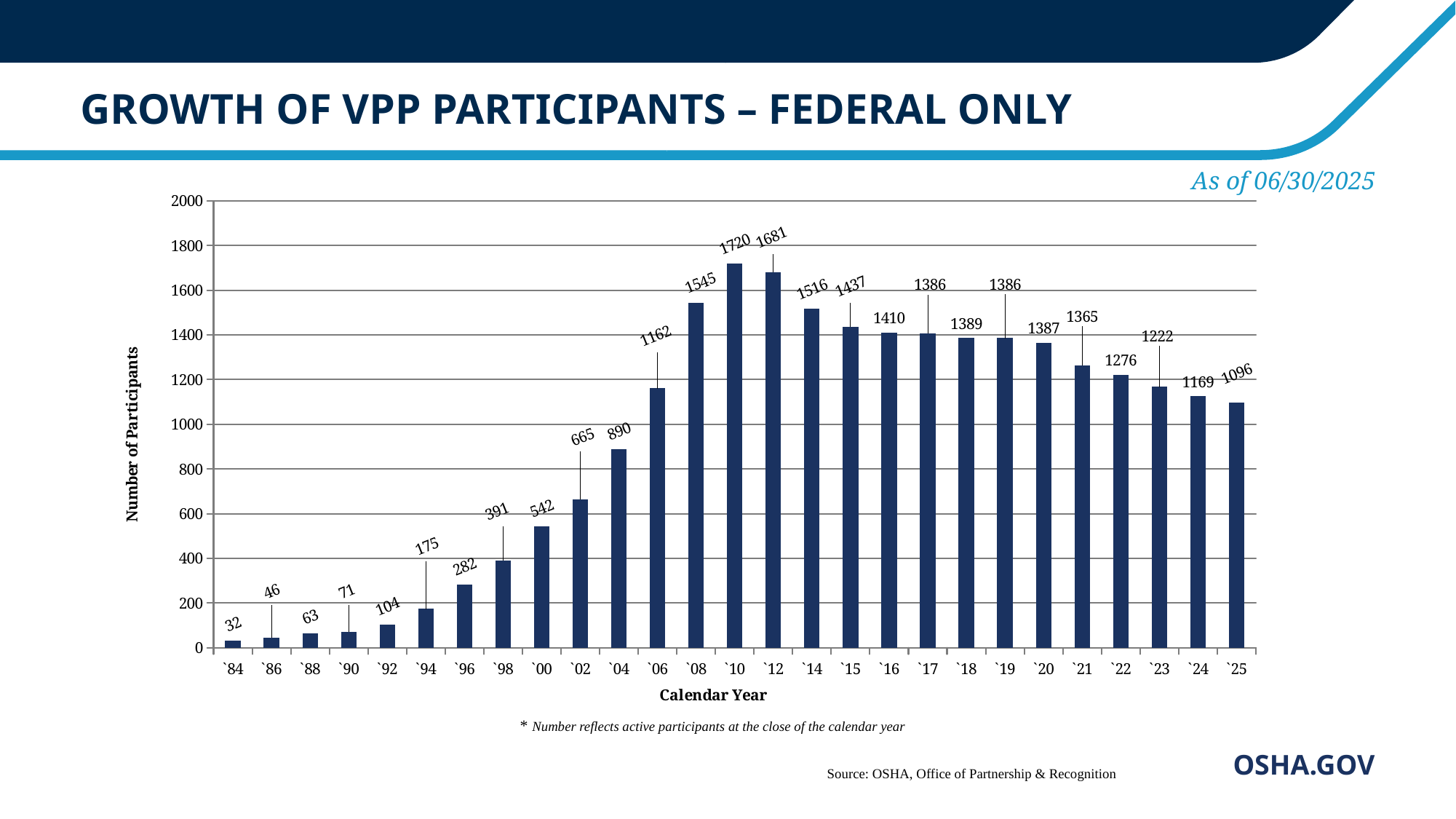
What is the difference in participants between `10 and `12? 39 Which has more participants, `08 or `14? `08 Which calendar year has the lowest number of participants? `84 What is the number of participants for `10? 1720 Which calendar year has the highest number of participants? `10 What kind of chart is shown on the slide? Bar chart Do the values rise or fall from `84 to `10? Rise What is the difference in participants between `24 and `25? 73 What is the number of participants for `25? 1096 Is the value for `06 greater or less than 1200? less How many calendar years are shown on the x axis? 27 What is the number of participants for `98? 391